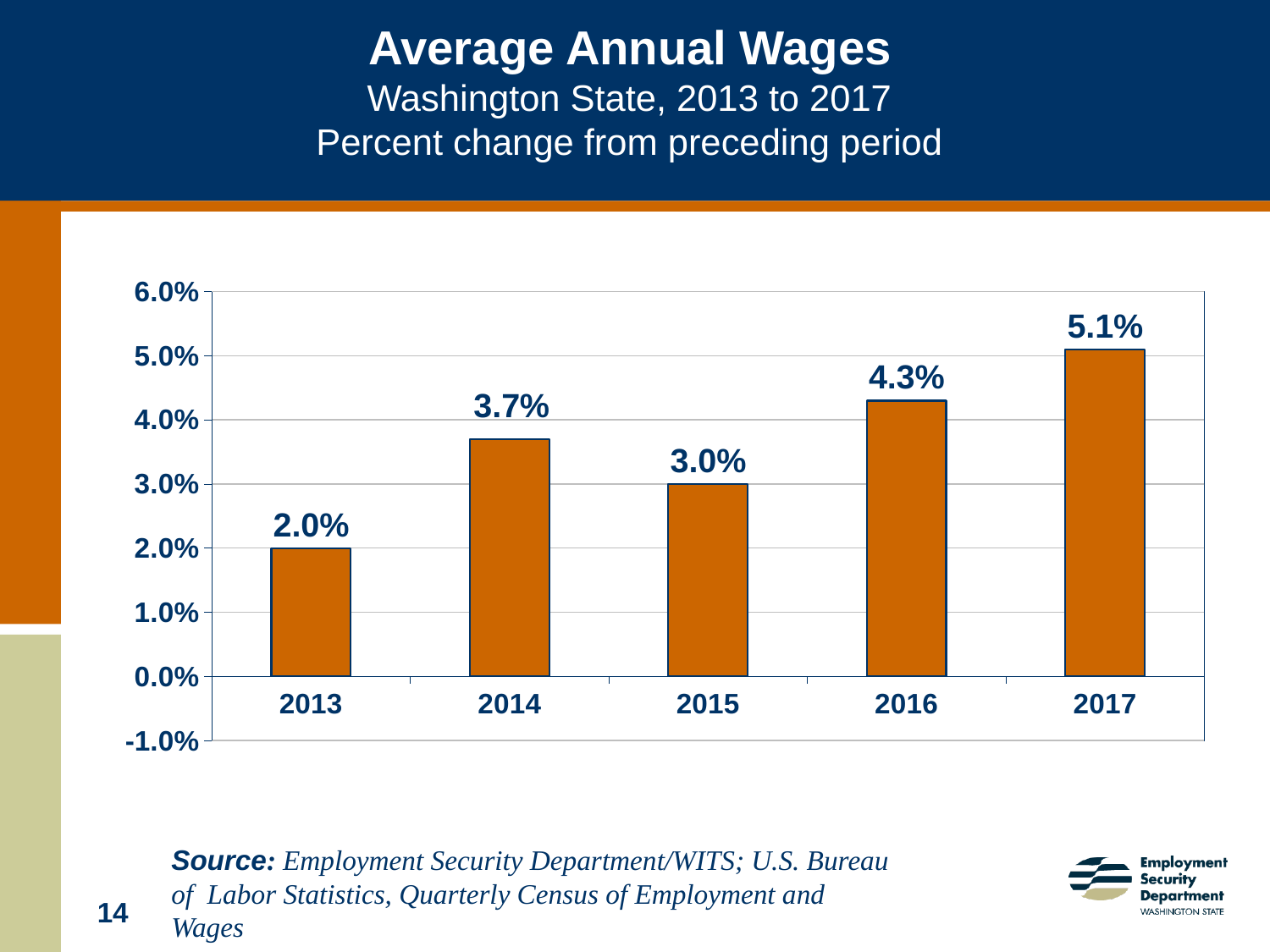
What is the difference between the percent change in 2014 and the percent change in 2015? 0.7% What is the percent change in average annual wages for 2017? 5.1% Which year has the lowest percent change in average annual wages? 2013 What is the percent change in average annual wages for 2015? 3.0% What is the percent change in average annual wages for 2013? 2.0% What kind of chart is shown on the slide? Bar chart Is the value for 2016 greater or less than 4.0%? greater What is the difference between the percent change in 2017 and the percent change in 2016? 0.8% What is the title of the chart on the slide? Average Annual Wages How many years are shown on the chart? 5 Which year has the highest percent change in average annual wages? 2017 Which year has a larger percent change, 2014 or 2016? 2016